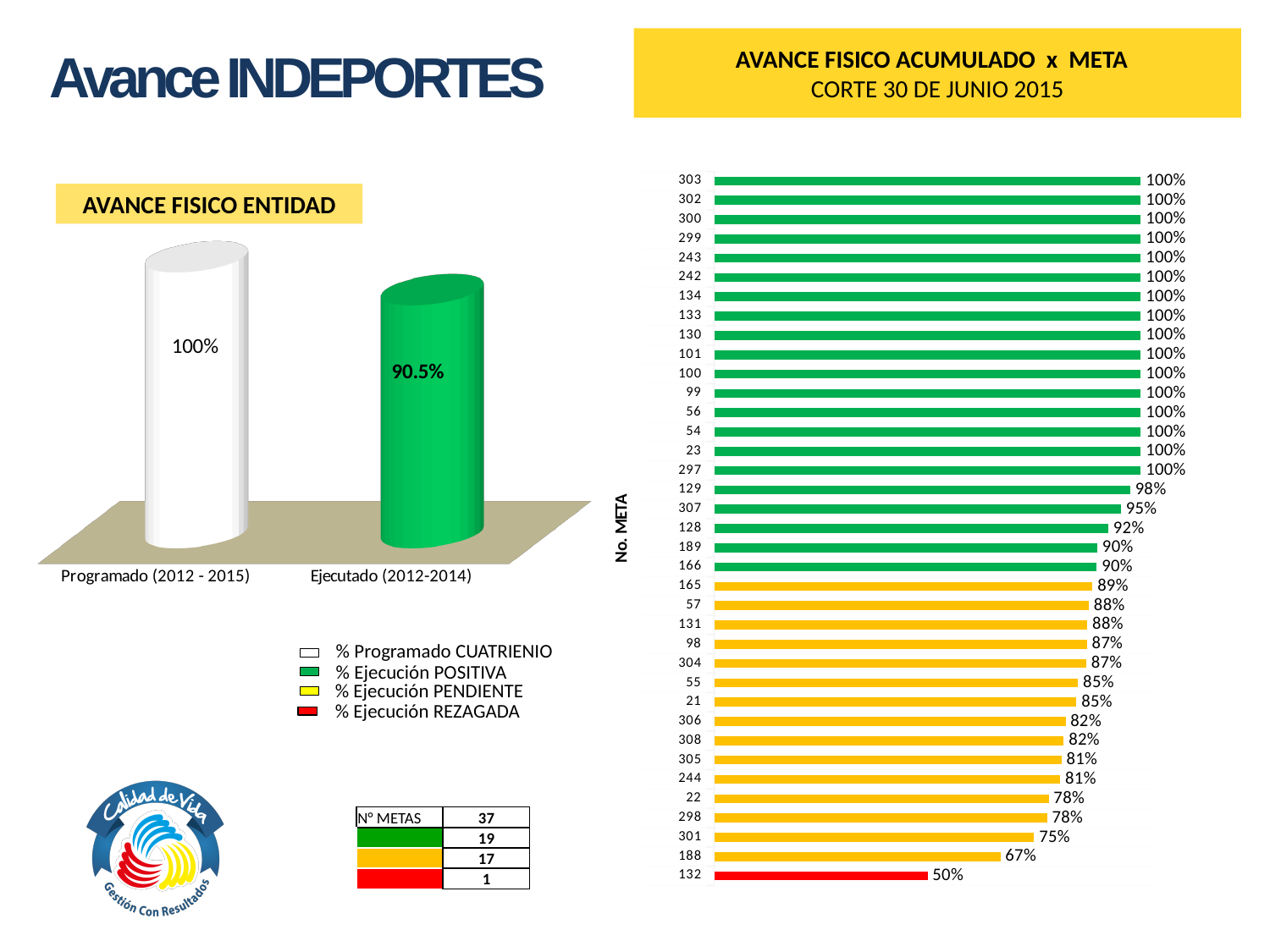
In the AVANCE FISICO ACUMULADO x META chart, which is larger, the value for meta 129 or the value for meta 128? 129 In the AVANCE FISICO ENTIDAD chart, what is the difference between Programado (2012 - 2015) and Ejecutado (2012-2014)? 9.5% What kind of chart is the AVANCE FISICO ACUMULADO x META chart? Bar chart In the AVANCE FISICO ENTIDAD chart, how many entries does the legend list? 4 In the AVANCE FISICO ACUMULADO x META chart, what is the value for meta 188? 67% In the AVANCE FISICO ENTIDAD chart, what is the value for Programado (2012 - 2015)? 100% In the AVANCE FISICO ACUMULADO x META chart, what is the value for meta 307? 95% In the AVANCE FISICO ENTIDAD chart, what is the value for Ejecutado (2012-2014)? 90.5% In the AVANCE FISICO ACUMULADO x META chart, what is the value for meta 132? 50% In the AVANCE FISICO ACUMULADO x META chart, which meta has the lowest value? 132 In the AVANCE FISICO ACUMULADO x META chart, what is the difference between the values for meta 165 and meta 301? 14% In the AVANCE FISICO ACUMULADO x META chart, how many metas are plotted? 37